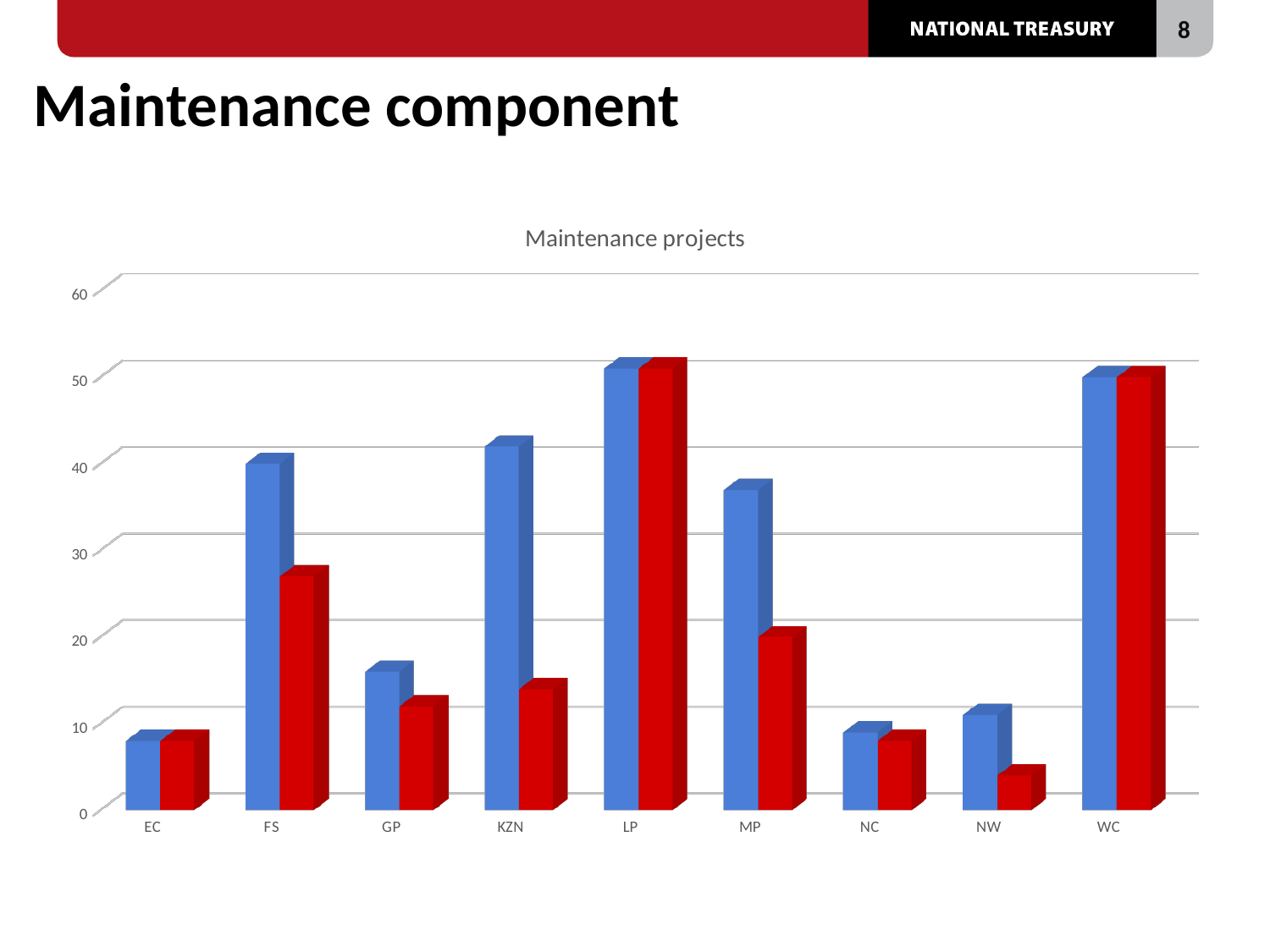
Is the red bar for FS greater or less than 30? less Is the blue bar for MP greater or less than 30? greater How many categories are shown on the x axis of the chart? 9 How many bars are plotted for each category in the chart? 2 Is the blue bar for FS greater or less than 30? greater For KZN, which is larger, the blue bar or the red bar? the blue bar Which category has the lowest red bar in the chart? NW What kind of chart is shown on the slide? bar chart What is the title of the chart? Maintenance projects Which is larger, the red bar for FS or the red bar for KZN? FS